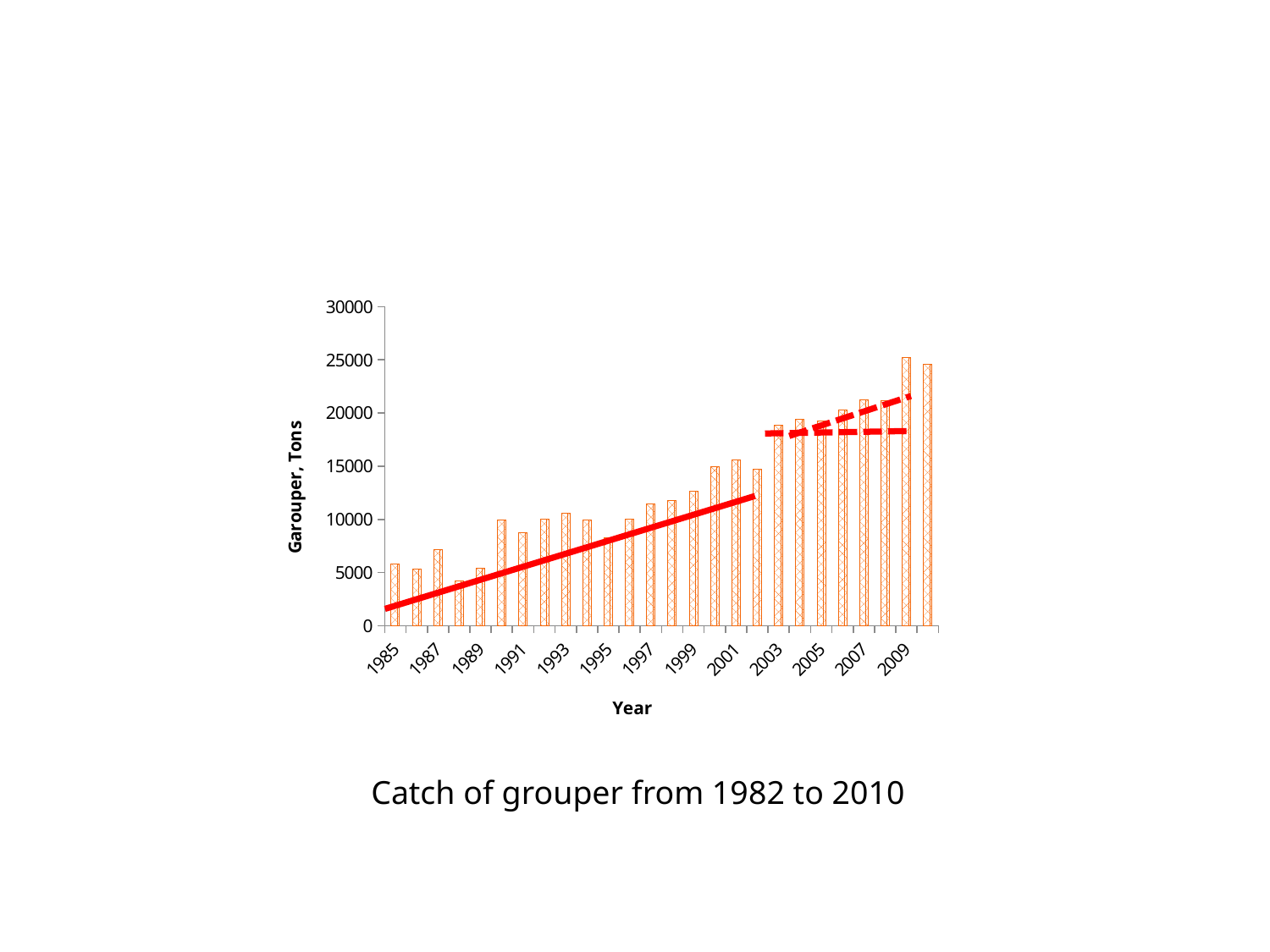
Is the value for 1985 greater or less than 10000? less Do the bar values generally rise or fall from 1985 to 2009? rise What is the title of the vertical axis? Garouper, Tons How many year labels are shown on the x axis? 13 What caption appears below the chart? Catch of grouper from 1982 to 2010 Is the value for 2009 greater or less than 20000? greater Is the value for 1997 greater or less than 10000? greater What kind of chart is shown on the slide? bar chart Which year has the tallest bar? 2009 Which is larger, the value for 1985 or the value for 1987? 1987